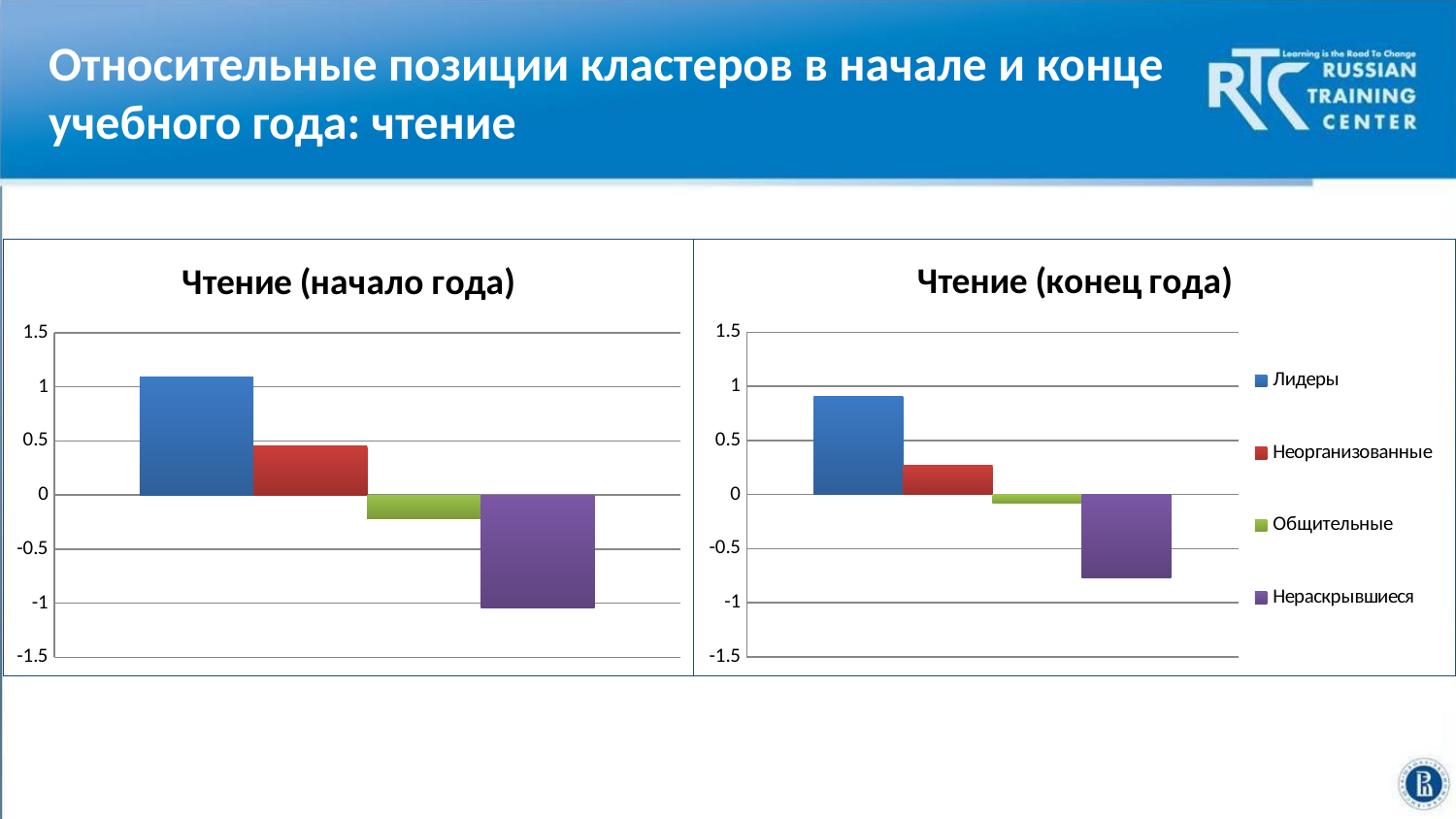
In the chart "Чтение (конец года)", is the value for Нераскрывшиеся greater or less than -1? greater In the chart "Чтение (конец года)", is the value for Неорганизованные greater or less than 0.5? less In the chart "Чтение (конец года)", which cluster has the highest value? Лидеры In the chart "Чтение (начало года)", which is larger: the value for Лидеры or the value for Неорганизованные? Лидеры In the chart "Чтение (начало года)", which cluster has the lowest value? Нераскрывшиеся In the chart "Чтение (конец года)", which cluster has the lowest value? Нераскрывшиеся What type of chart is "Чтение (начало года)"? bar chart In the chart "Чтение (конец года)", is the value for Лидеры greater or less than 1? less In the chart "Чтение (начало года)", which cluster has the highest value? Лидеры How many series does the legend list on the slide? 4 How many bars are plotted in the chart "Чтение (конец года)"? 4